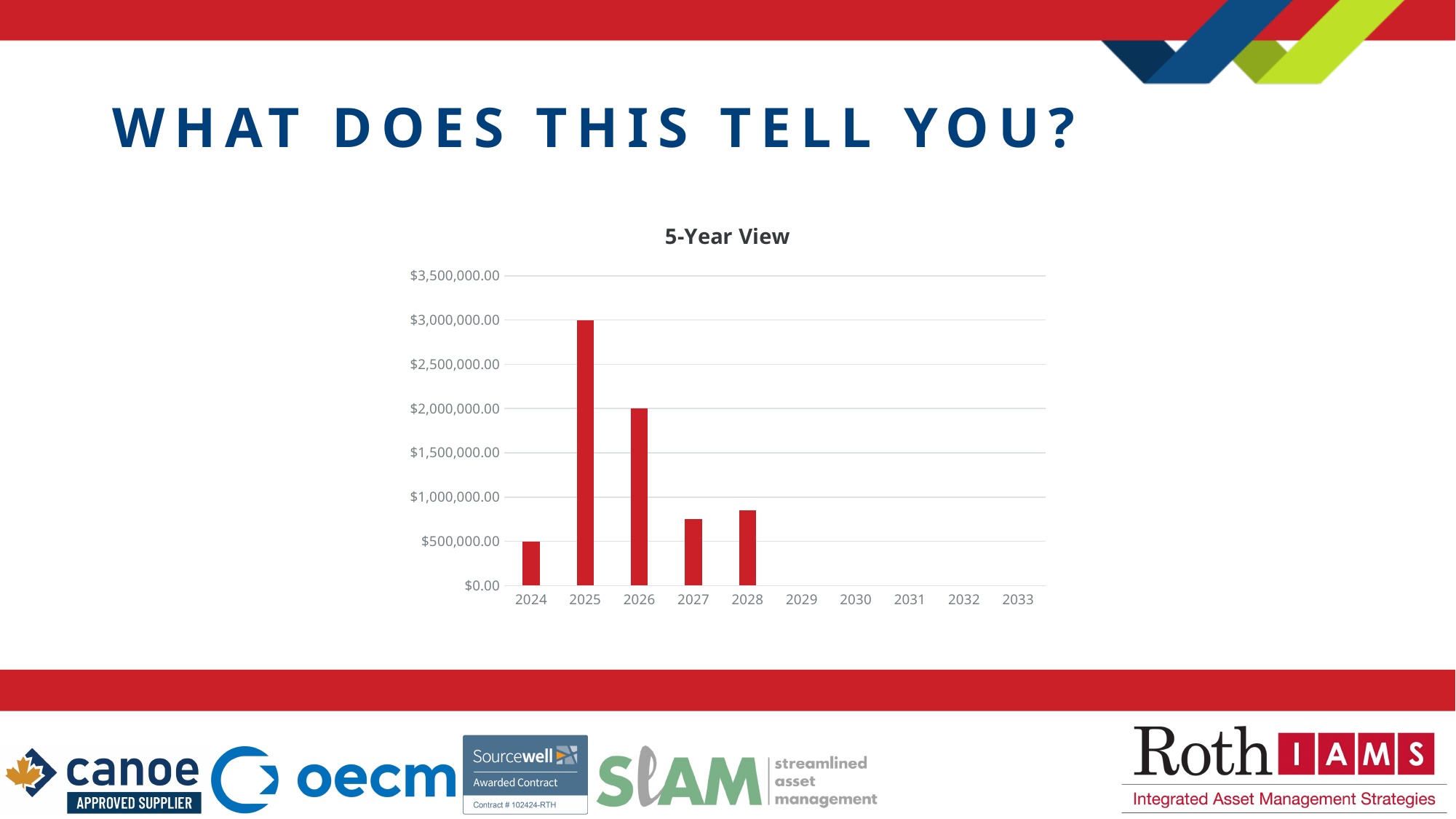
Is the value for 2028 greater or less than $500,000.00? greater How many years are labelled on the x axis? 10 What is the difference between the values for 2025 and 2026? $1,000,000.00 What is the value for 2025? $3,000,000.00 What is the value for 2024? $500,000.00 Which year has the highest value in the chart? 2025 What is the value for 2026? $2,000,000.00 What kind of chart is shown on the slide? bar chart Do the values rise or fall from 2024 to 2025? rise Which is larger, the value for 2025 or the value for 2026? 2025 What is the title of the chart? 5-Year View Is the value for 2027 greater or less than $1,000,000.00? less